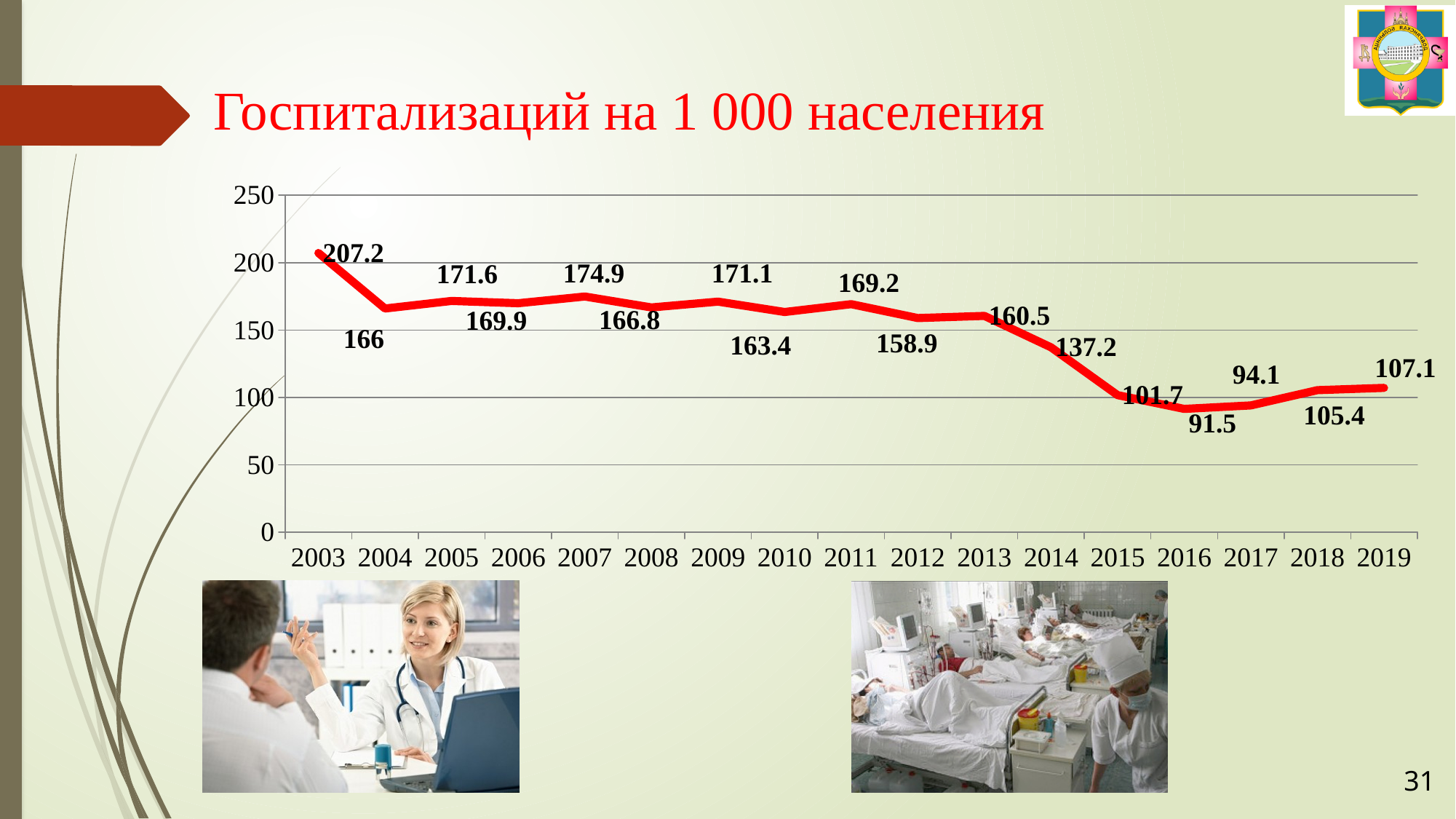
Which is larger, the value for 2007 or the value for 2010? 2007 What is the value for 2014? 137.2 What is the difference between the values for 2003 and 2004? 41.2 What is the value for 2016? 91.5 Which year has the lowest value? 2016 What is the title of the chart? Госпитализаций на 1 000 населения What type of chart is shown on the slide? line chart What is the value for 2003? 207.2 What is the value for 2019? 107.1 Overall, do the values rise or fall from 2003 to 2019? fall Which year has the highest value? 2003 How many years are plotted on the x axis? 17